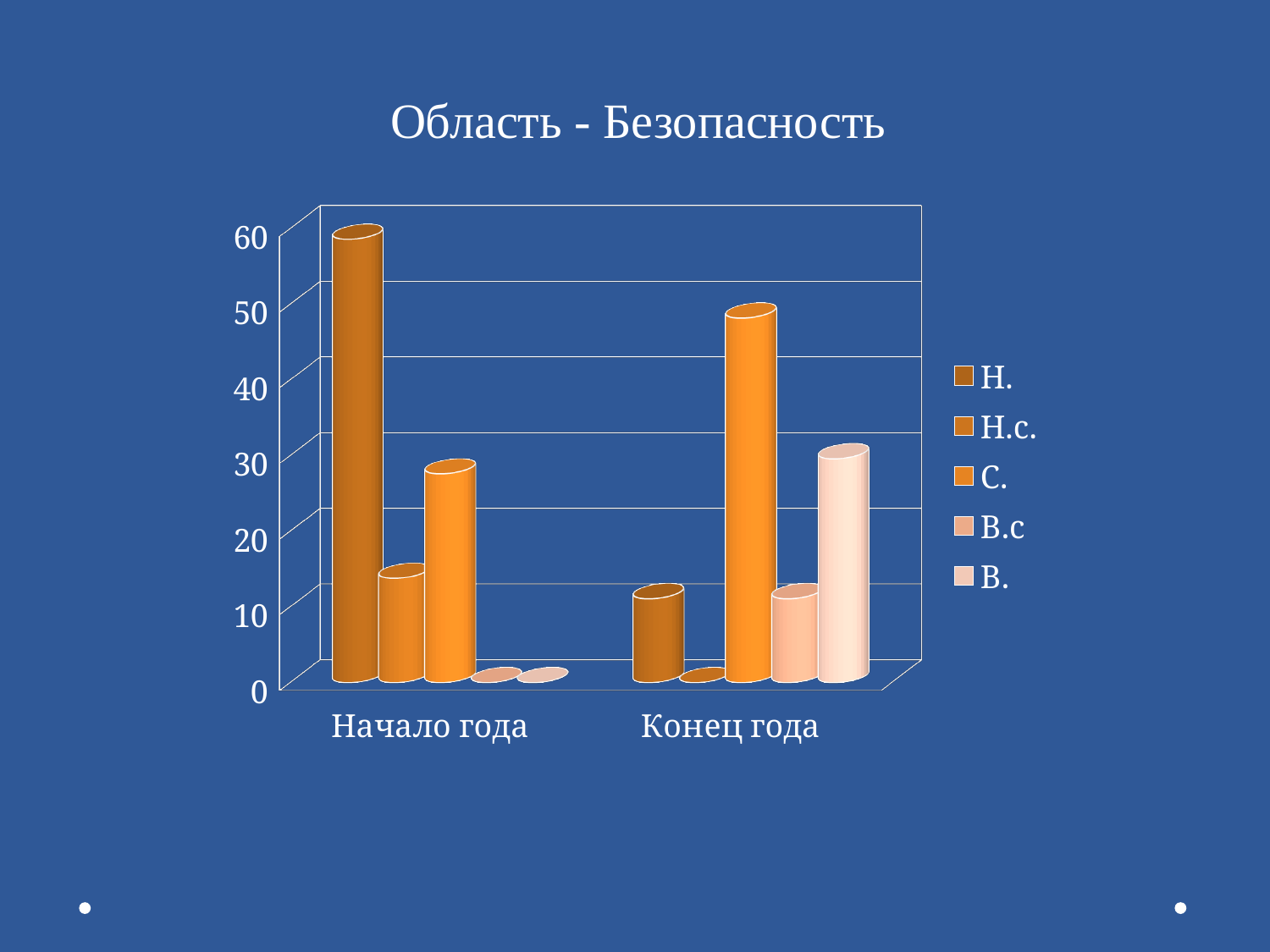
How many categories are shown on the x axis? 2 Which series has the highest value for Начало года? Н. Which series has the highest value for Конец года? С. What is the title of the chart? Область - Безопасность Is the value for Н.с. at Начало года greater or less than 20? less Which is larger: the value for Н. at Начало года or the value for Н. at Конец года? Начало года What kind of chart is shown on the slide? bar chart Is the value for Н. at Начало года greater or less than 50? greater Is the value for В. at Конец года greater or less than 20? greater How many series does the legend list? 5 Does the value for С. rise or fall from Начало года to Конец года? rise